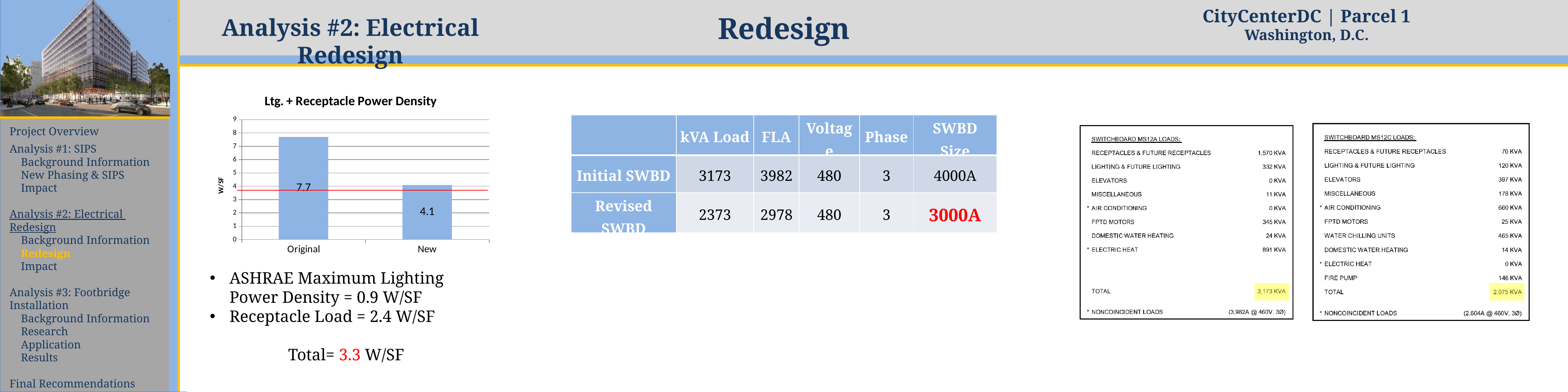
What is the value for New in the Ltg. + Receptacle Power Density chart? 4.1 What is the difference between the Original and New values in the Ltg. + Receptacle Power Density chart? 3.6 Is the value for New greater or less than 5 in the Ltg. + Receptacle Power Density chart? less Do the values rise or fall from Original to New in the Ltg. + Receptacle Power Density chart? fall What is the value for Original in the Ltg. + Receptacle Power Density chart? 7.7 What type of chart is the Ltg. + Receptacle Power Density chart? bar chart Which category has the lowest value in the Ltg. + Receptacle Power Density chart? New Is the value for Original greater or less than 7 in the Ltg. + Receptacle Power Density chart? greater How many categories are shown in the Ltg. + Receptacle Power Density chart? 2 Which category has the highest value in the Ltg. + Receptacle Power Density chart? Original What is the y-axis label of the Ltg. + Receptacle Power Density chart? W/SF Is the value for Original larger or smaller than the value for New in the Ltg. + Receptacle Power Density chart? larger